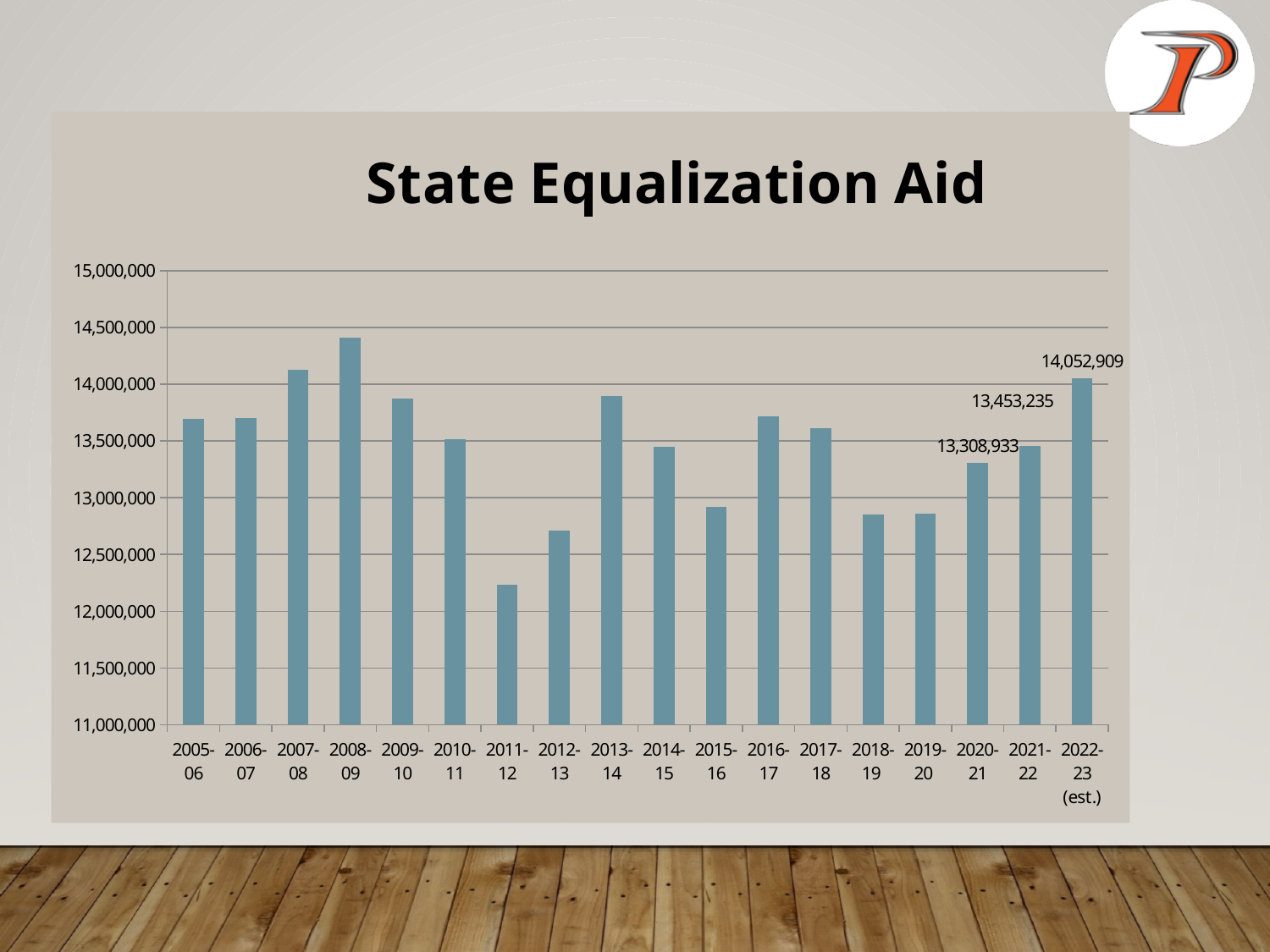
What kind of chart is shown on the slide? bar chart Which year has the highest State Equalization Aid? 2008-09 What is the value for 2022-23 (est.) in the State Equalization Aid chart? 14,052,909 Which is larger, the value for 2009-10 or the value for 2010-11? 2009-10 What is the value for 2020-21 in the State Equalization Aid chart? 13,308,933 What is the difference between the 2022-23 (est.) value and the 2021-22 value? 599,674 What is the difference between the 2021-22 value and the 2020-21 value? 144,302 How many years are shown on the x axis of the chart? 18 Is the value for 2011-12 greater or less than 12,500,000? less Which year has the lowest State Equalization Aid? 2011-12 Is the value for 2018-19 greater or less than 13,000,000? less What is the value for 2021-22 in the State Equalization Aid chart? 13,453,235